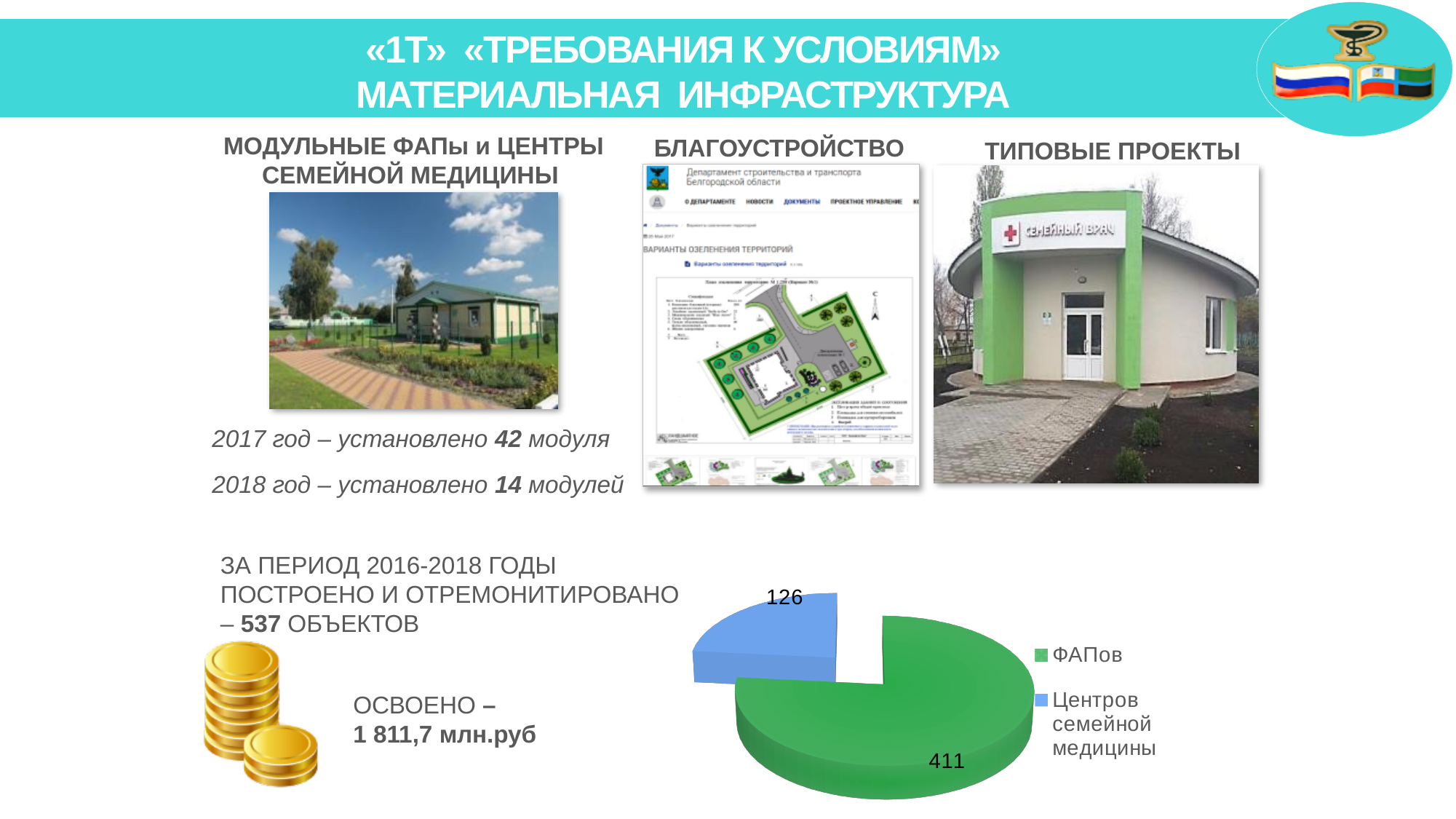
What is the value for Центров семейной медицины in the pie chart? 126 How many slices does the pie chart have? 2 What colour is the Центров семейной медицины slice in the pie chart? blue Which category has the largest slice in the pie chart? ФАПов What kind of chart is shown on the slide? pie chart What is the total of the two values shown in the pie chart? 537 What is the difference between the values for ФАПов and Центров семейной медицины? 285 What is the value for ФАПов in the pie chart? 411 Which category has the smallest slice in the pie chart? Центров семейной медицины Which is larger: the value for ФАПов or the value for Центров семейной медицины? ФАПов How many entries does the legend of the pie chart list? 2 What colour is the ФАПов slice in the pie chart? green